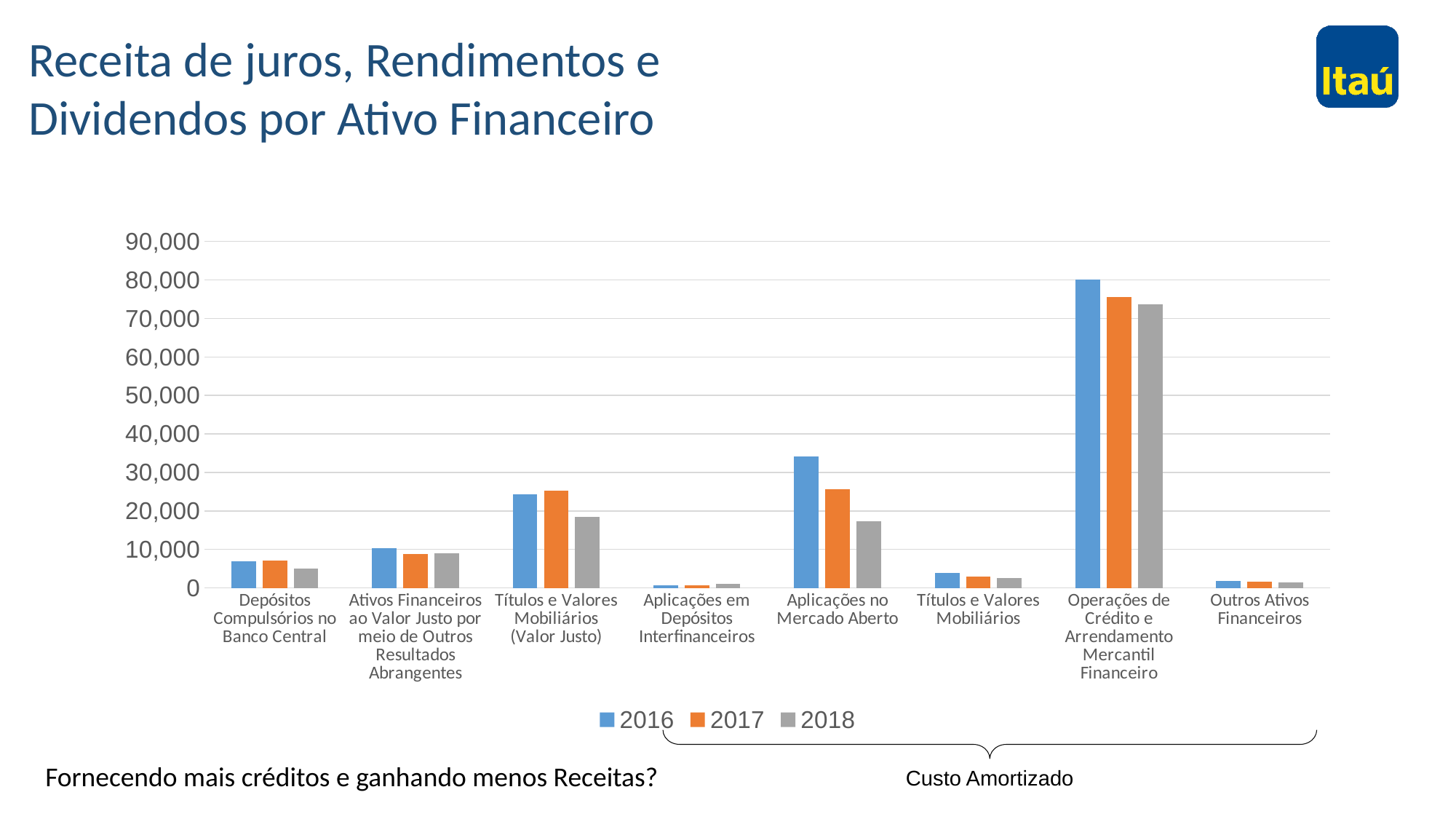
Is the 2016 value for Depósitos Compulsórios no Banco Central greater or less than 10,000? less How many categories are shown on the x axis? 8 What kind of chart is shown on the slide? bar chart Is the 2018 value for Operações de Crédito e Arrendamento Mercantil Financeiro greater or less than 70,000? greater How many series does the legend list? 3 Do the values for Operações de Crédito e Arrendamento Mercantil Financeiro rise or fall from 2016 to 2018? fall Which years are listed in the chart legend? 2016, 2017, 2018 Is the 2018 value for Títulos e Valores Mobiliários (Valor Justo) greater or less than 20,000? less Which category has the highest bar in the chart? Operações de Crédito e Arrendamento Mercantil Financeiro Which category has the lowest bars in the chart? Aplicações em Depósitos Interfinanceiros For Aplicações no Mercado Aberto, which year has the larger value, 2016 or 2018? 2016